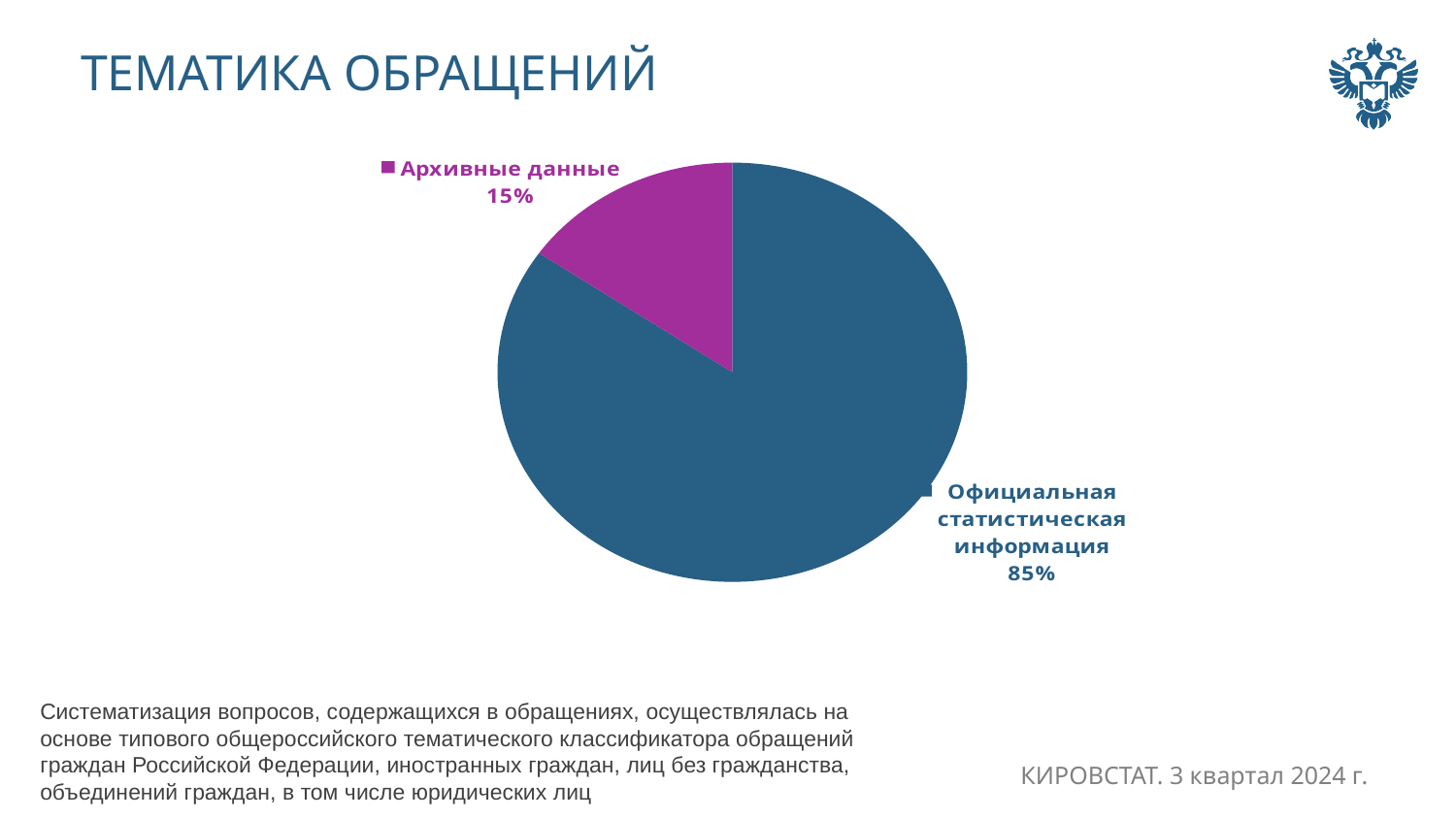
Which category has the smallest slice of the pie? Архивные данные Which category has the largest slice of the pie? Официальная статистическая информация Which is larger: the share for "Архивные данные" or the share for "Официальная статистическая информация"? Официальная статистическая информация What colour is the slice for "Архивные данные"? purple What share of the pie does "Архивные данные" represent? 15% What is the difference in percentage points between "Официальная статистическая информация" and "Архивные данные"? 70 What is the title of the slide containing the chart? ТЕМАТИКА ОБРАЩЕНИЙ How many categories are shown in the pie chart? 2 What share of the pie does "Официальная статистическая информация" represent? 85% What kind of chart is shown on the slide? pie chart